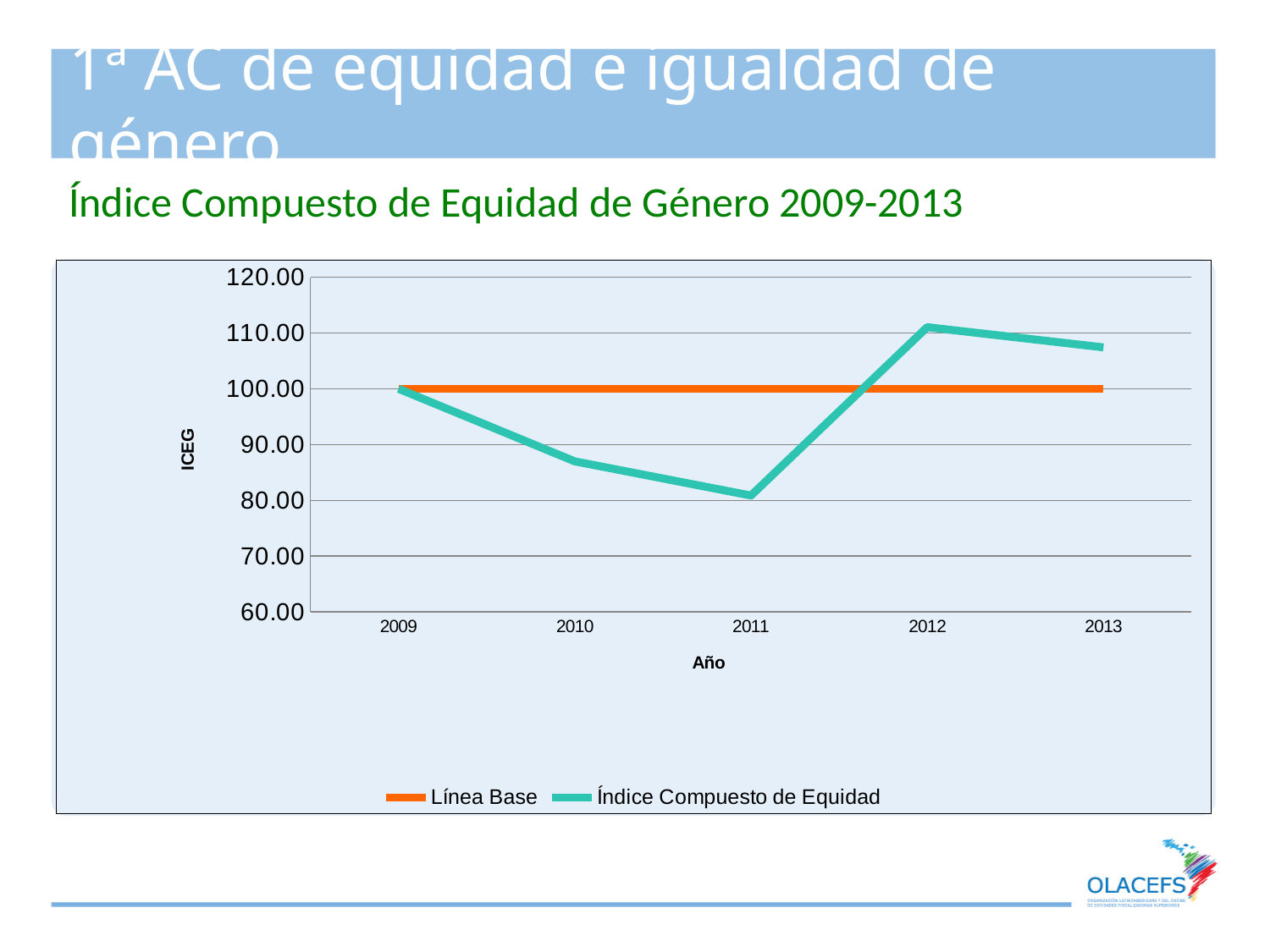
What is the value of Línea Base in 2011? 100.00 What kind of chart is shown on the slide? line chart In which year is Índice Compuesto de Equidad at its highest? 2012 What is the title of the x axis? Año In which year is Índice Compuesto de Equidad at its lowest? 2011 Which year has the higher value of Índice Compuesto de Equidad, 2012 or 2013? 2012 How many years are plotted along the x axis? 5 Does Índice Compuesto de Equidad rise or fall from 2009 to 2011? fall Is the value of Índice Compuesto de Equidad in 2011 greater or less than 90.00? less How many series does the legend list? 2 Is the value of Índice Compuesto de Equidad in 2010 greater or less than 90.00? less Is the value of Índice Compuesto de Equidad in 2012 greater or less than 100.00? greater